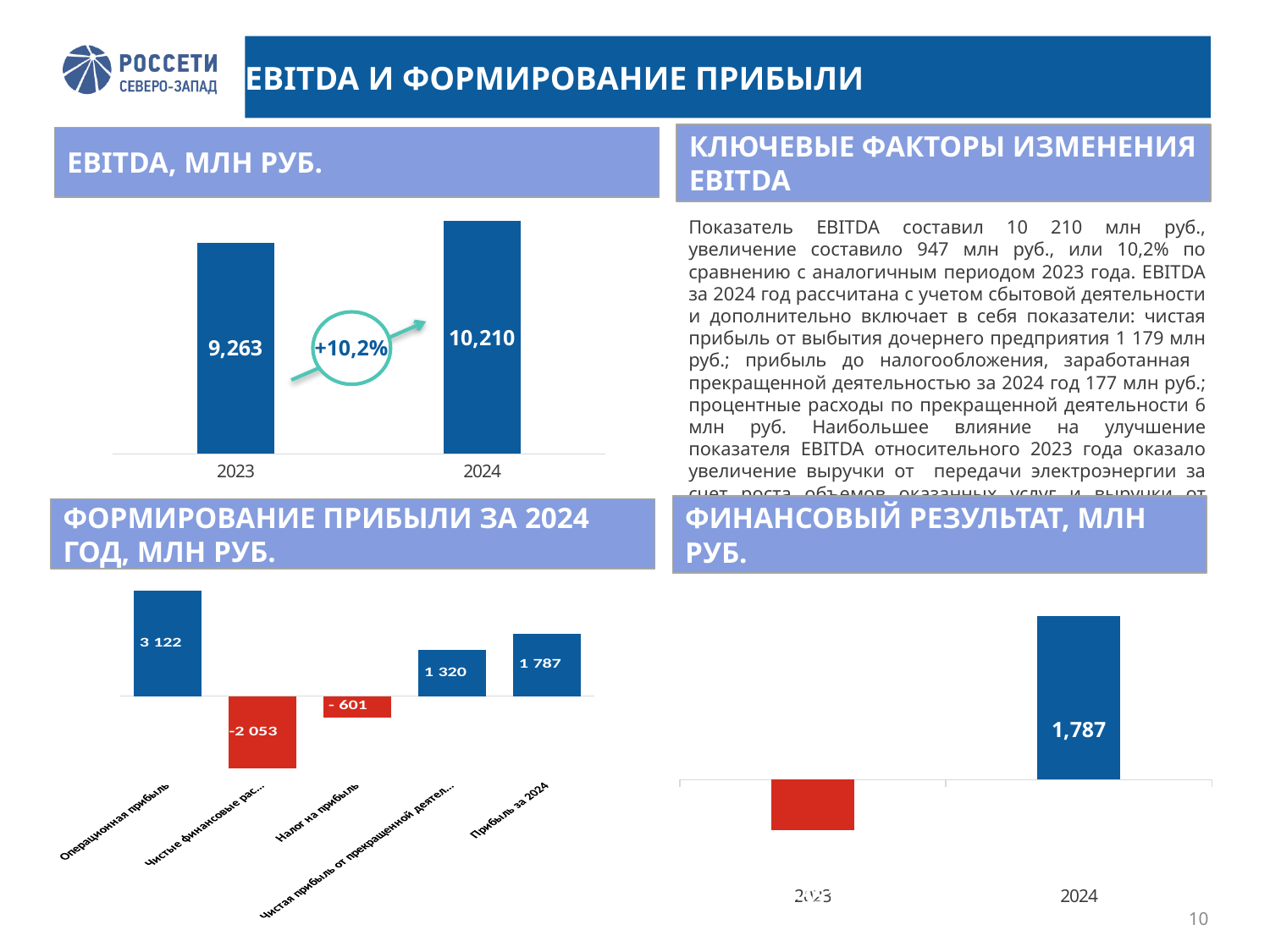
In the 'EBITDA, МЛН РУБ.' chart, what is the difference between the 2024 and 2023 values? 947 In the 'ФИНАНСОВЫЙ РЕЗУЛЬТАТ, МЛН РУБ.' chart, what is the value for 2024? 1,787 In the 'EBITDA, МЛН РУБ.' chart, do the values rise or fall from 2023 to 2024? rise In the 'ФОРМИРОВАНИЕ ПРИБЫЛИ ЗА 2024 ГОД, МЛН РУБ.' chart, what is the value for Налог на прибыль? - 601 In the 'ФОРМИРОВАНИЕ ПРИБЫЛИ ЗА 2024 ГОД, МЛН РУБ.' chart, which category has the highest value? Операционная прибыль In the 'ФОРМИРОВАНИЕ ПРИБЫЛИ ЗА 2024 ГОД, МЛН РУБ.' chart, what is the value for Операционная прибыль? 3 122 In the 'EBITDA, МЛН РУБ.' chart, what is the EBITDA value for 2024? 10,210 What kind of chart is the 'EBITDA, МЛН РУБ.' chart? bar chart In the 'ФОРМИРОВАНИЕ ПРИБЫЛИ ЗА 2024 ГОД, МЛН РУБ.' chart, how many bars are plotted? 5 In the 'ФОРМИРОВАНИЕ ПРИБЫЛИ ЗА 2024 ГОД, МЛН РУБ.' chart, what is the value for Прибыль за 2024? 1 787 In the 'EBITDA, МЛН РУБ.' chart, what percentage change is shown between 2023 and 2024? +10,2% In the 'EBITDA, МЛН РУБ.' chart, what is the EBITDA value for 2023? 9,263